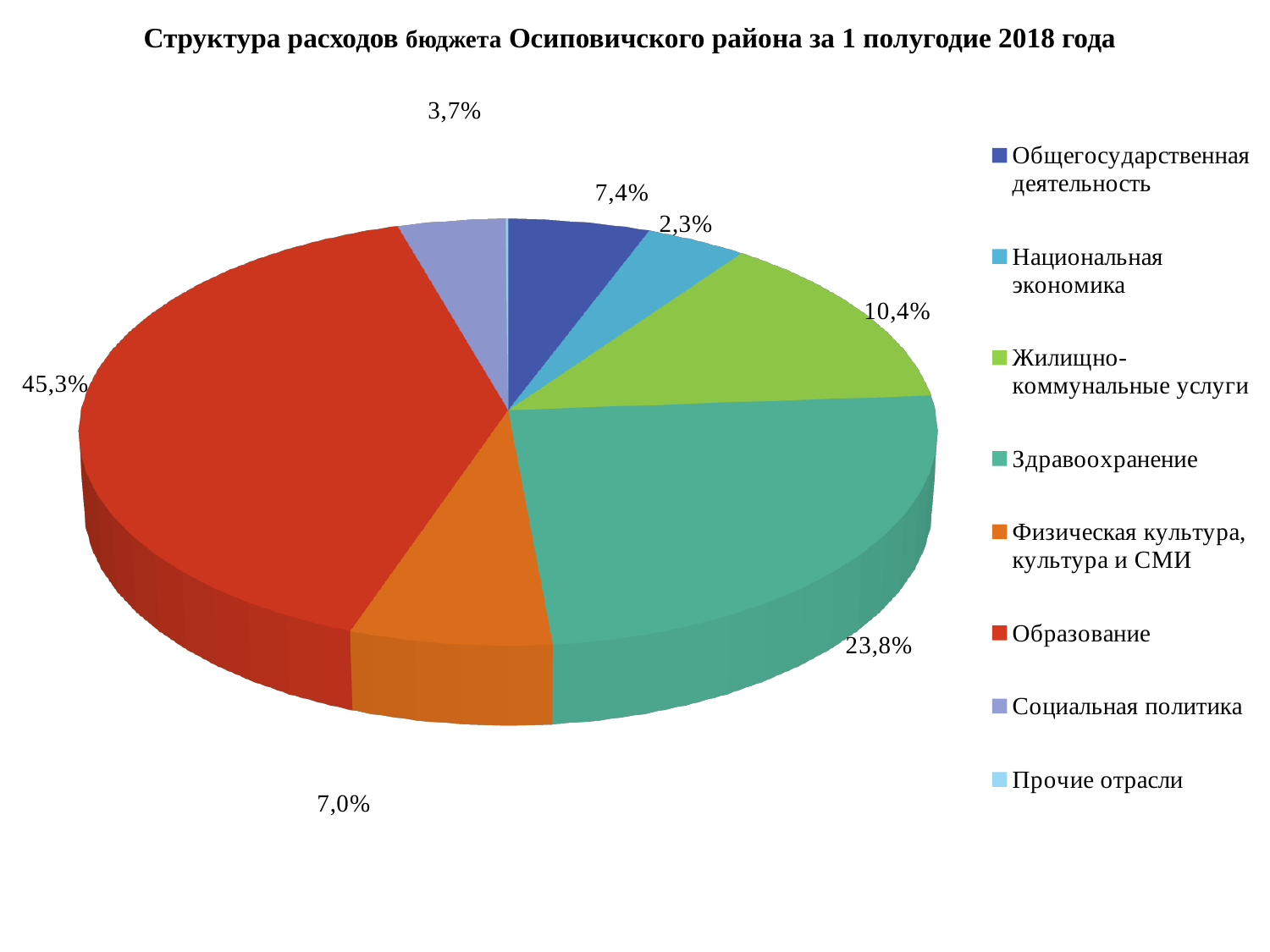
Which category has the largest share of the budget expenditures? Образование Which is larger, Здравоохранение or Жилищно-коммунальные услуги? Здравоохранение What is the value shown for Здравоохранение? 23,8% What kind of chart is shown on the slide? pie chart What is the value for Социальная политика? 3,7% What share of expenditures does Образование account for? 45,3% How many categories does the legend list? 8 What colour is the slice for Физическая культура, культура и СМИ? orange What percentage is shown for Жилищно-коммунальные услуги? 10,4% What is the value for Общегосударственная деятельность? 7,4% What share is shown for Национальная экономика? 2,3% What is the difference between the shares of Образование and Здравоохранение? 21,5%